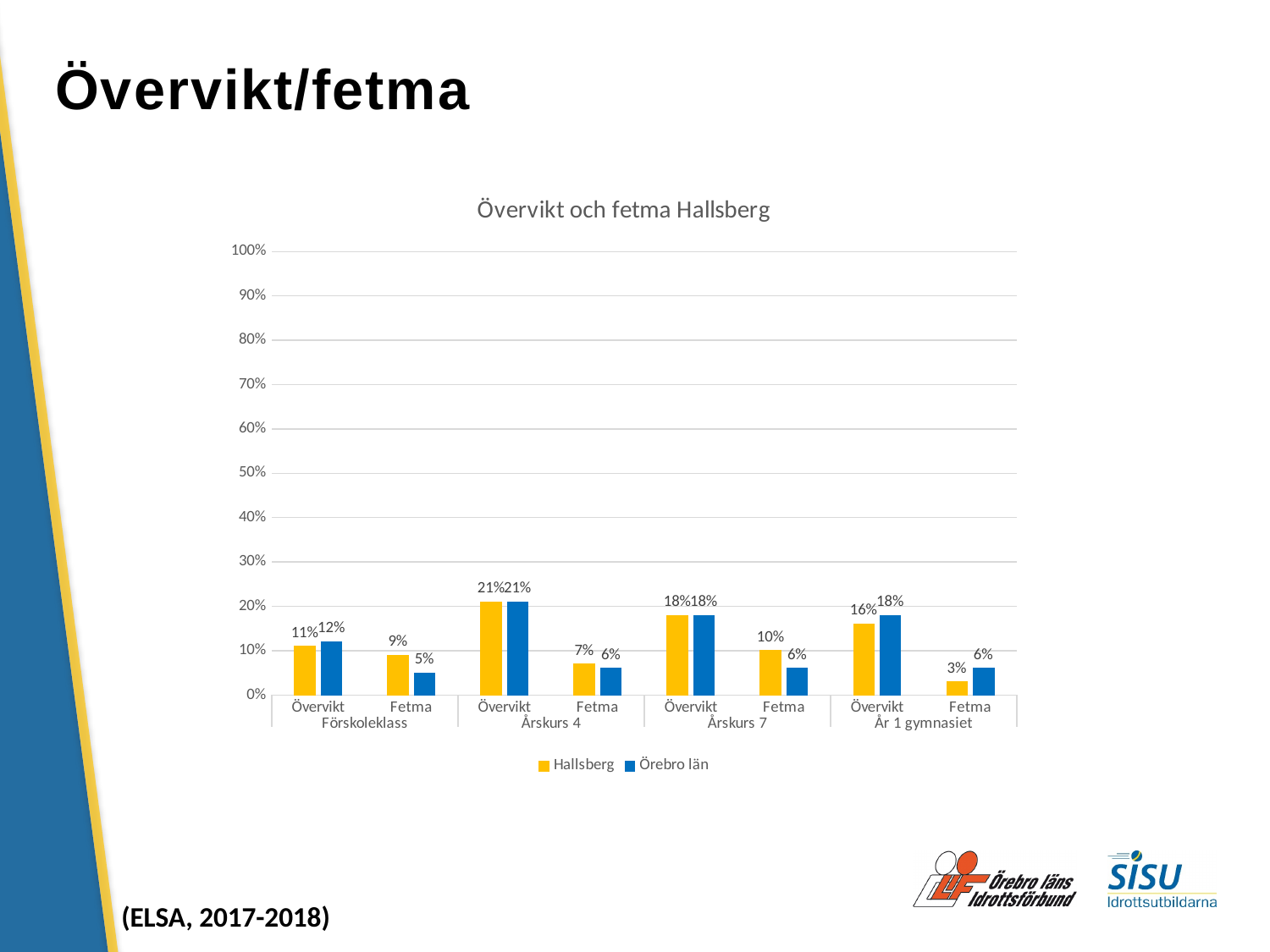
How many school-level groups are shown on the x axis? 4 Which category has the lowest Hallsberg value? Fetma, År 1 gymnasiet For Fetma in Förskoleklass, which is larger: Hallsberg or Örebro län? Hallsberg What is the Örebro län value for Fetma in Förskoleklass? 5% Which category has the highest Hallsberg value? Övervikt, Årskurs 4 How many series does the legend list? 2 What is the Hallsberg value for Fetma in År 1 gymnasiet? 3% What is the Örebro län value for Övervikt in År 1 gymnasiet? 18% What is the difference between the Hallsberg and Örebro län values for Fetma in Årskurs 7? 4 percentage points What kind of chart is shown on the slide? Bar chart What is the Hallsberg value for Övervikt in Förskoleklass? 11% What is the title of the chart? Övervikt och fetma Hallsberg